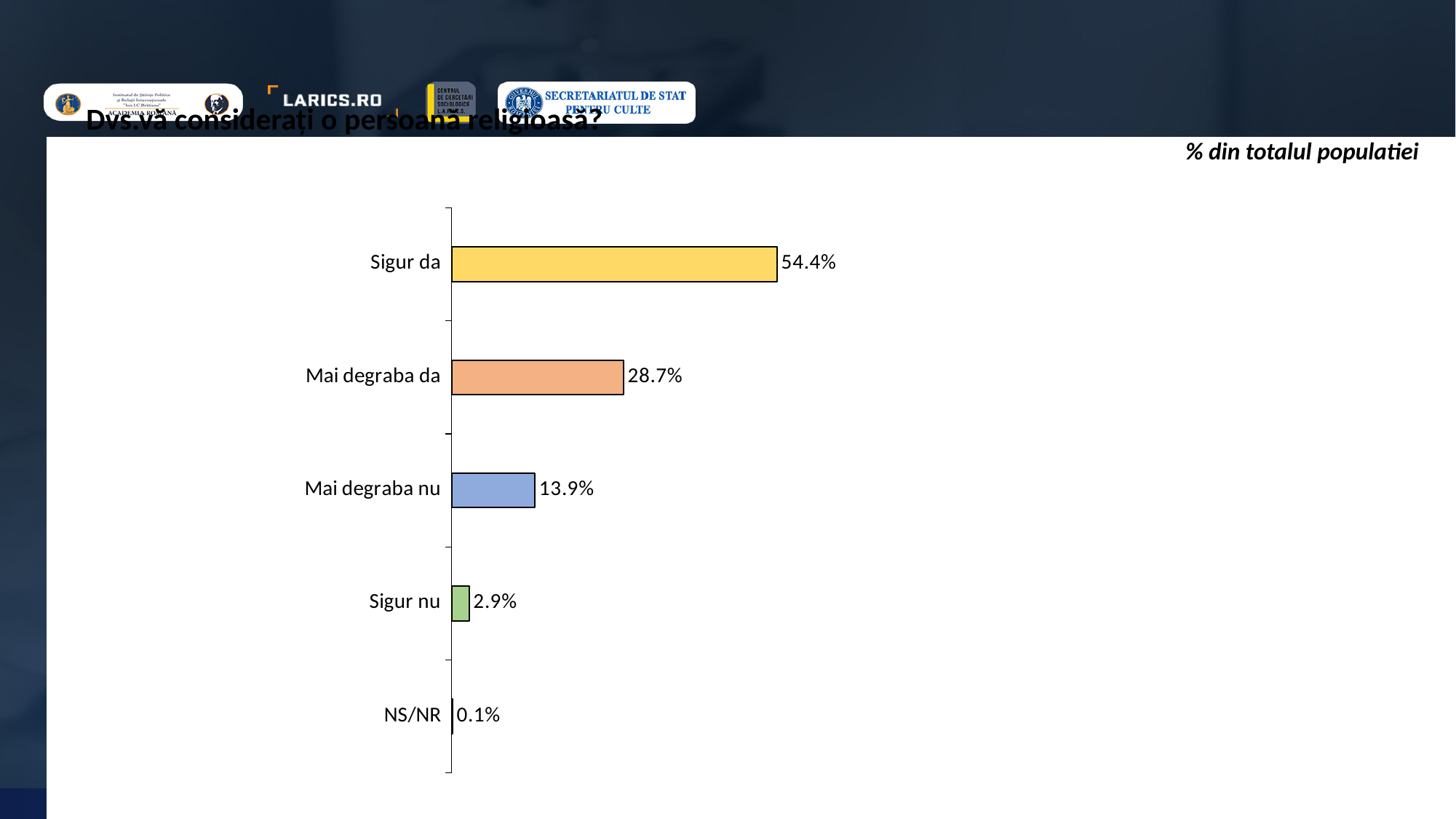
What is the value for "Mai degraba da"? 28.7% What is the value for "NS/NR"? 0.1% Which category has the lowest value? NS/NR What unit note is shown at the top right of the chart? % din totalul populatiei What is the difference between the values for "Sigur da" and "Mai degraba da"? 25.7% Which category has the highest value? Sigur da Which is larger, the value for "Mai degraba nu" or the value for "Sigur nu"? Mai degraba nu What is the value for "Mai degraba nu"? 13.9% What is the value for "Sigur nu"? 2.9% What is the value for "Sigur da"? 54.4% What kind of chart is shown on the slide? Bar chart How many categories are shown in the chart? 5